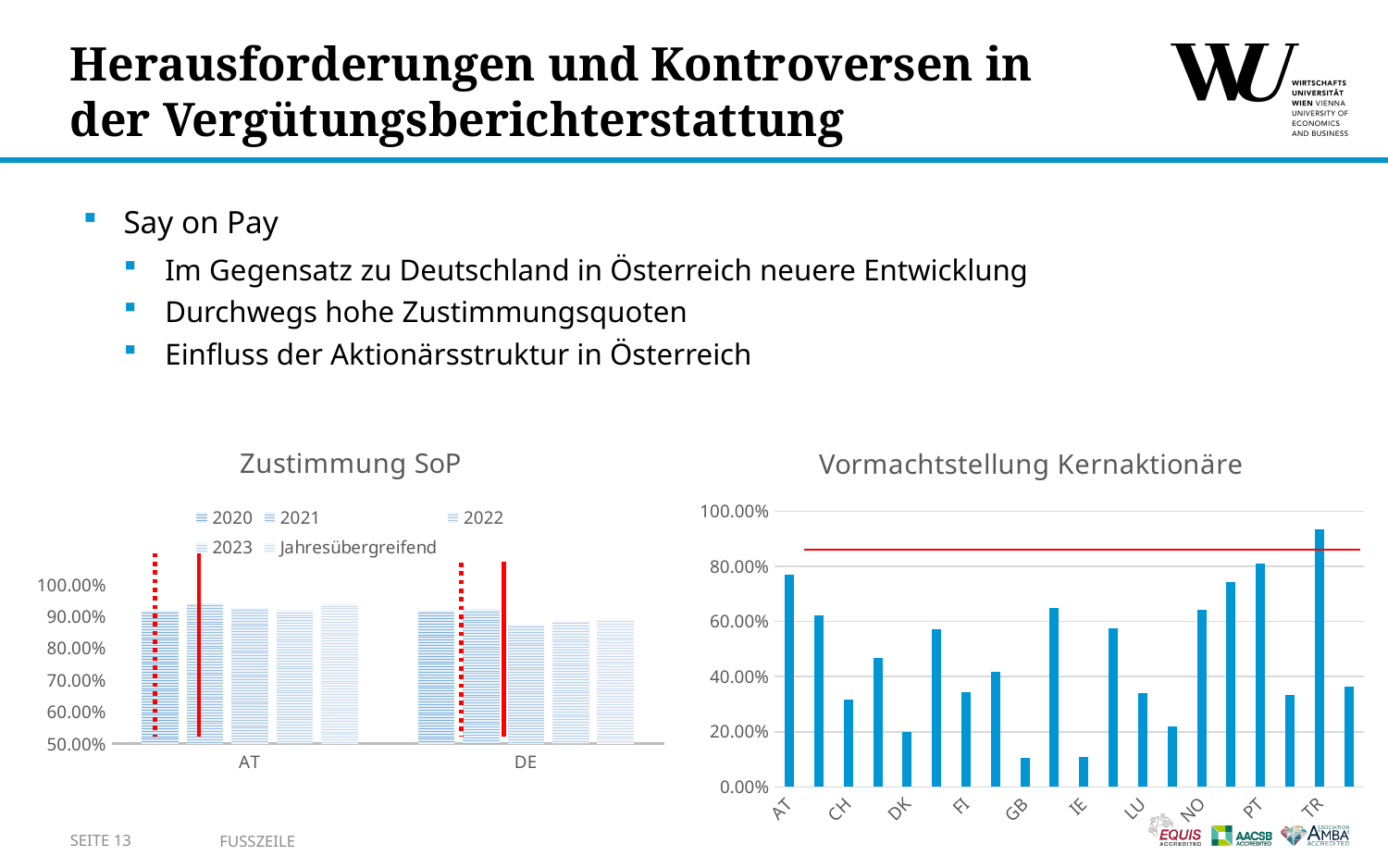
What type of chart is the 'Vormachtstellung Kernaktionäre' chart? bar chart In the 'Zustimmung SoP' chart, how many series does the legend list? 5 What type of chart is the 'Zustimmung SoP' chart? bar chart In the 'Zustimmung SoP' chart, how many categories are shown on the x axis? 2 In the 'Vormachtstellung Kernaktionäre' chart, is the value for GB greater or less than 20.00%? less In the 'Zustimmung SoP' chart, is the 2021 value for AT greater or less than 90.00%? greater In the 'Vormachtstellung Kernaktionäre' chart, is the value for TR greater or less than 80.00%? greater In the 'Zustimmung SoP' chart, which series are listed in the legend? 2020, 2021, 2022, 2023, Jahresübergreifend In the 'Vormachtstellung Kernaktionäre' chart, which has the larger value, AT or CH? AT In the 'Zustimmung SoP' chart, which has the larger Jahresübergreifend value, AT or DE? AT In the 'Vormachtstellung Kernaktionäre' chart, which labeled category has the highest value? TR